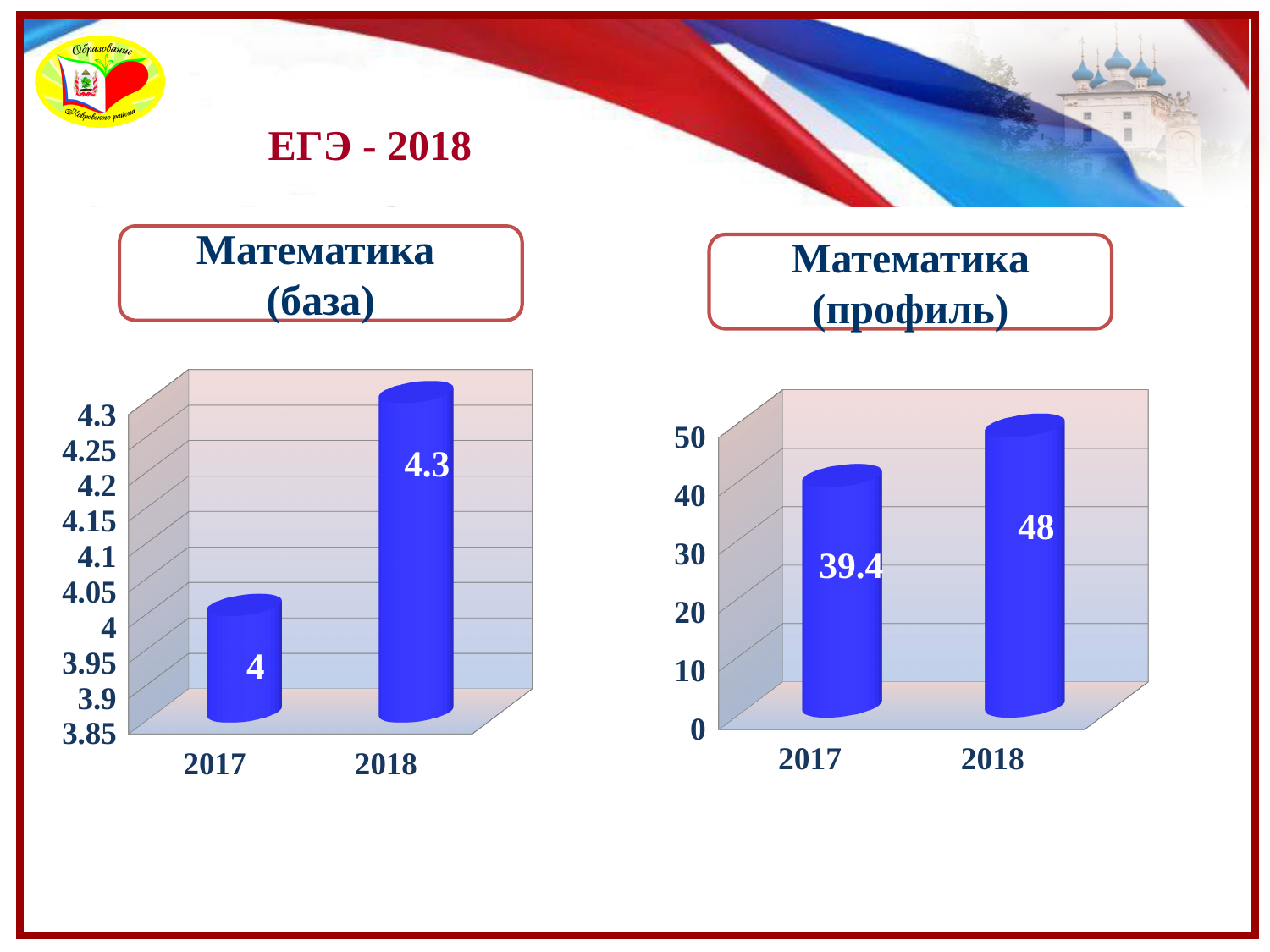
In the Математика (база) chart, which year has the lowest value? 2017 What kind of chart is the Математика (профиль) chart? bar chart In the Математика (профиль) chart, what is the difference between the 2018 and 2017 values? 8.6 In the Математика (профиль) chart, is the value for 2017 greater or less than 40? less In the Математика (профиль) chart, what is the value for 2018? 48 In the Математика (база) chart, do the values rise or fall from 2017 to 2018? rise In the Математика (база) chart, what is the difference between the 2018 and 2017 values? 0.3 In the Математика (профиль) chart, which year has the highest value? 2018 In the Математика (база) chart, what is the value for 2017? 4 In the Математика (база) chart, how many years are shown? 2 In the Математика (база) chart, what is the value for 2018? 4.3 In the Математика (профиль) chart, what is the value for 2017? 39.4